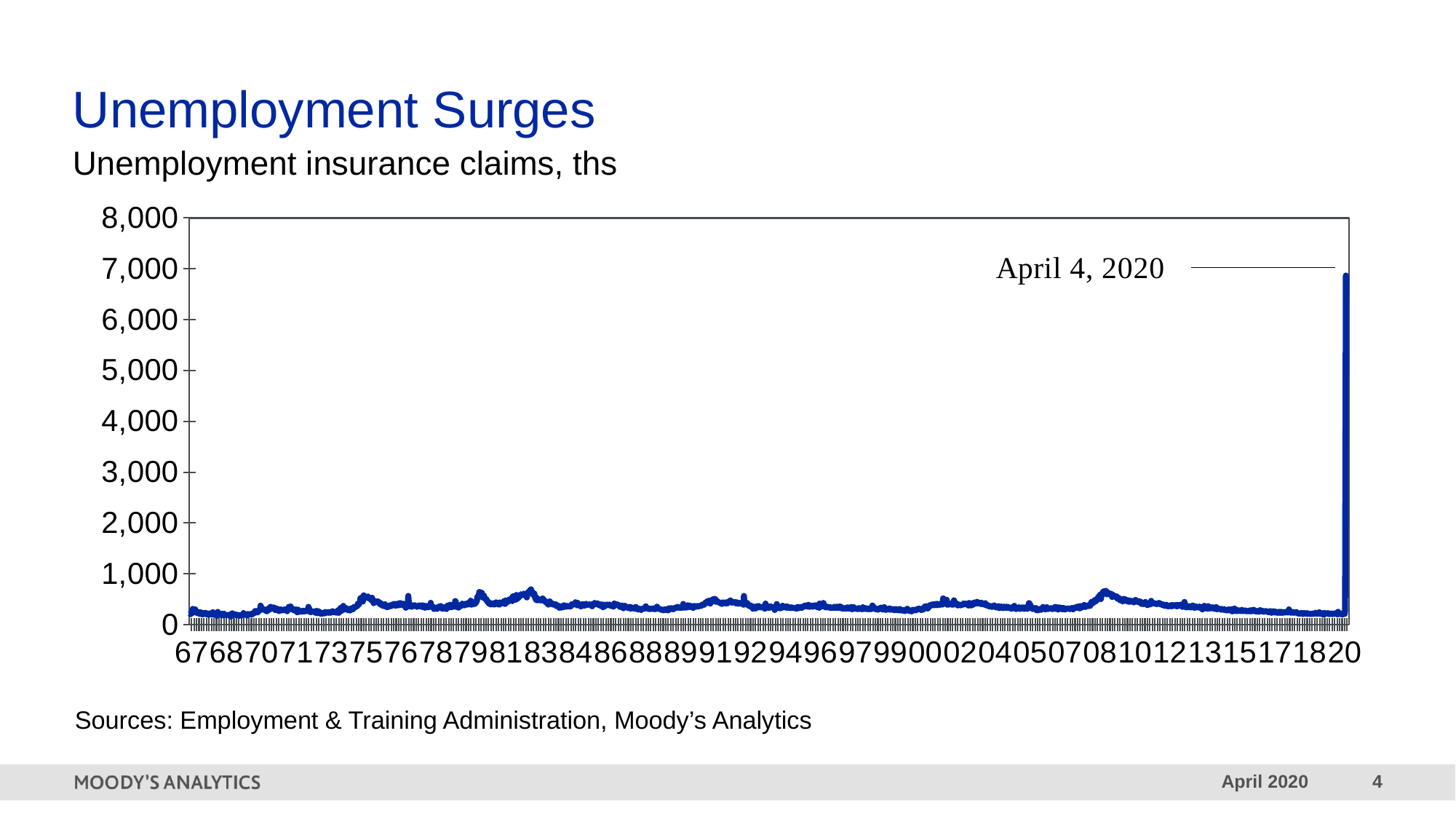
Is the peak value around 2008-2009 greater or less than 1,000? less What is the first year label shown on the horizontal axis? 67 What is the title of the chart on the slide? Unemployment Surges Is the value for April 4, 2020 larger or smaller than the value at the 2008-2009 peak? larger What is the last year label shown on the horizontal axis? 20 Which date is annotated as the point where the line spikes to its highest value? April 4, 2020 What unit is the chart's subtitle stated in for unemployment insurance claims? ths Is the value for April 4, 2020 greater or less than 6,000? greater What is the highest value shown on the vertical axis? 8,000 What kind of chart is shown on the slide? line chart Is the peak value around 1982 greater or less than 1,000? less